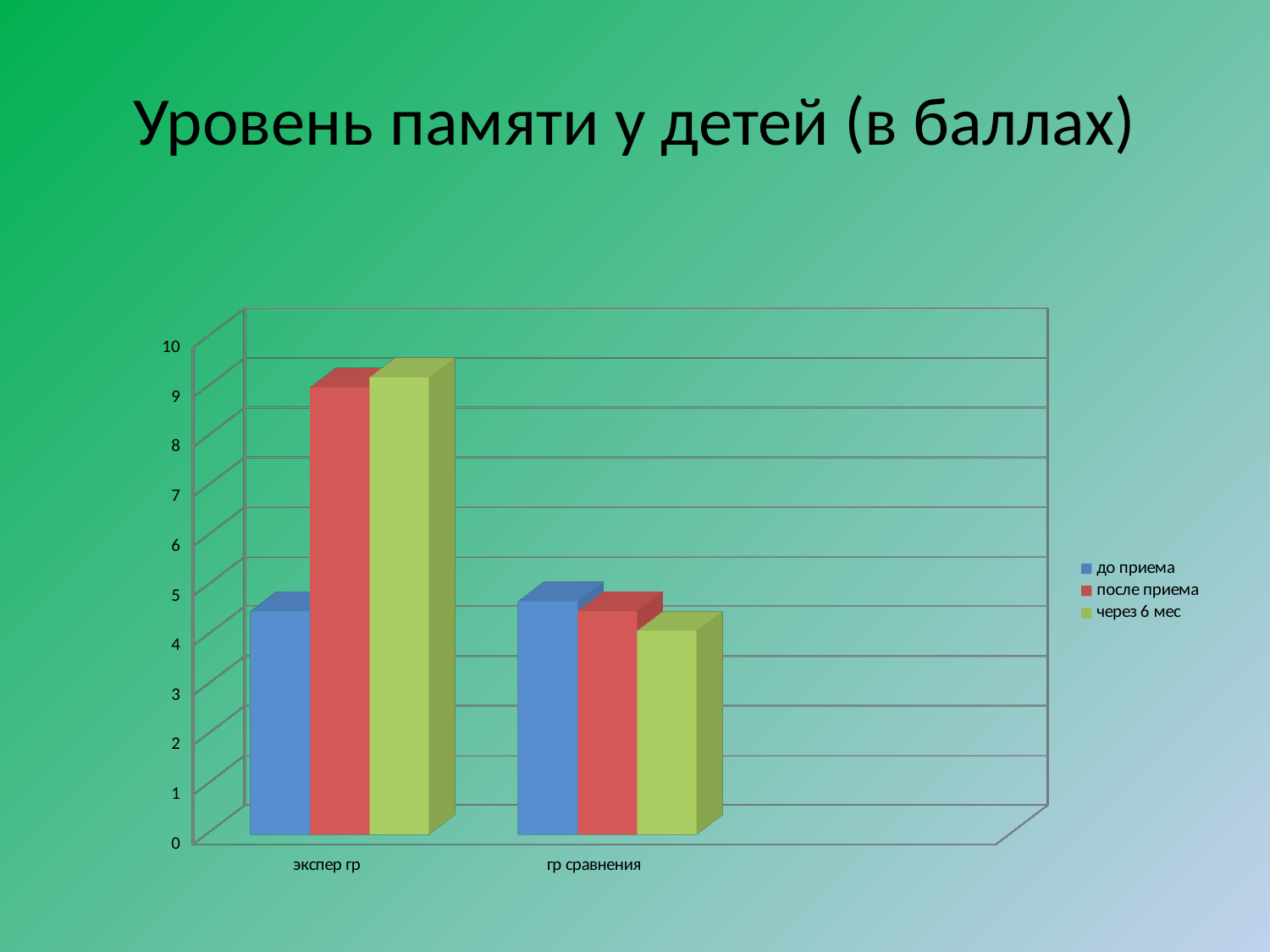
In the "гр сравнения" category, which is larger: "до приема" or "через 6 мес"? до приема Which series is shown in red in the legend? после приема In the "экспер гр" category, which is larger: "до приема" or "после приема"? после приема What is the title of the chart on the slide? Уровень памяти у детей (в баллах) Is the value for "через 6 мес" in the "экспер гр" category greater or less than 8? greater How many series does the legend list? 3 What kind of chart is shown on the slide? bar chart Is the value for "после приема" in the "экспер гр" category greater or less than 8? greater How many categories are shown on the x axis? 2 Is the value for "до приема" in the "экспер гр" category greater or less than 6? less Which category has the higher value for "после приема": "экспер гр" or "гр сравнения"? экспер гр